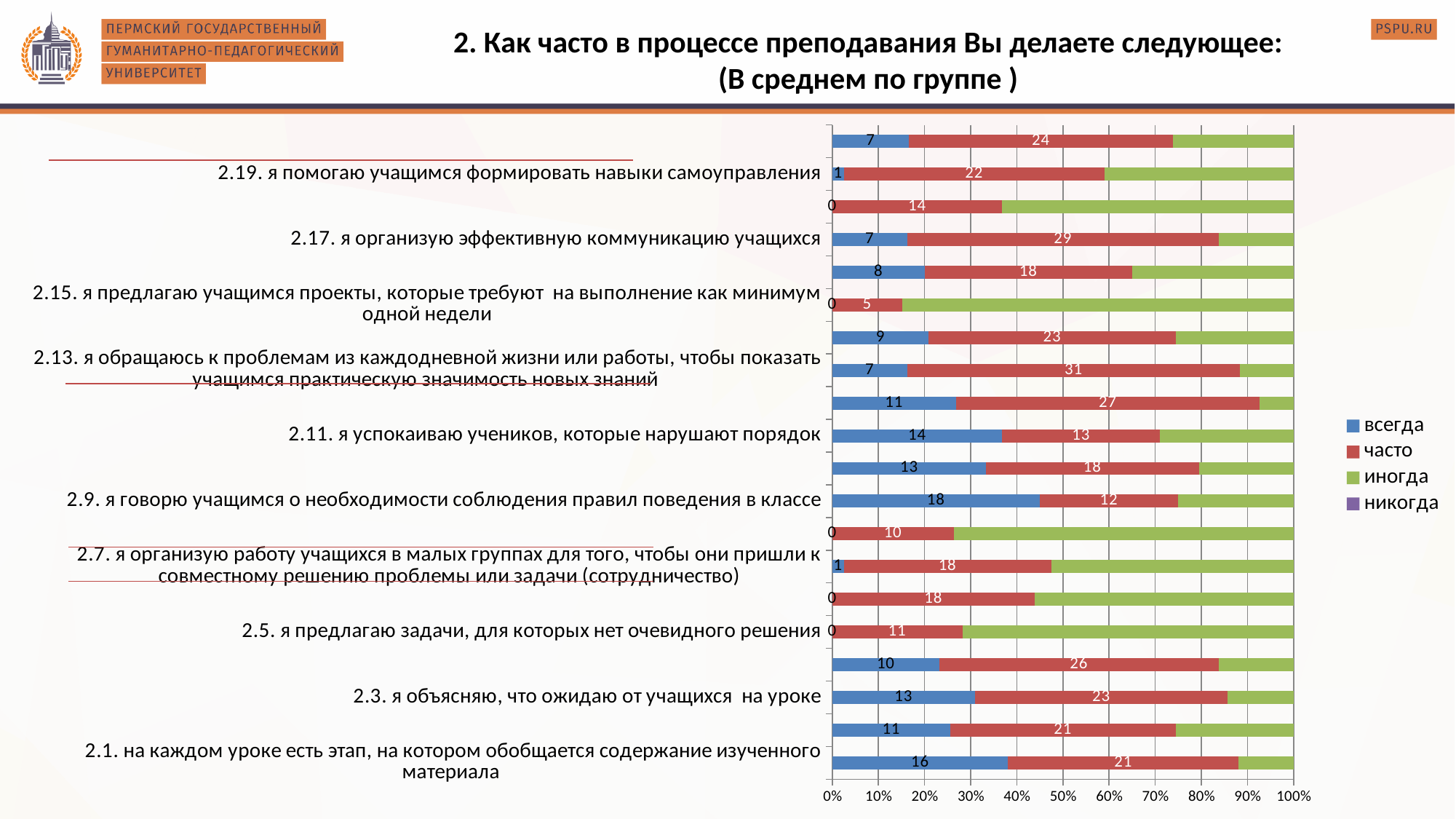
What is the value of the 'всегда' series for '2.5. я предлагаю задачи, для которых нет очевидного решения'? 0 Is the share of 'иногда' for '2.15. я предлагаю учащимся проекты, которые требуют на выполнение как минимум одной недели' greater or less than 80%? greater Which category has the highest value in the 'всегда' series? 2.9. я говорю учащимся о необходимости соблюдения правил поведения в классе Which has the larger 'часто' value: '2.17. я организую эффективную коммуникацию учащихся' or '2.11. я успокаиваю учеников, которые нарушают порядок'? 2.17. я организую эффективную коммуникацию учащихся What is the value of the 'часто' series for '2.15. я предлагаю учащимся проекты, которые требуют на выполнение как минимум одной недели'? 5 What is the difference between the 'всегда' values for '2.1. на каждом уроке есть этап...' and '2.3. я объясняю, что ожидаю от учащихся на уроке'? 3 How many series does the legend list? 4 What colour represents the 'часто' series in the legend? Red What is the value of the 'часто' series for '2.13. я обращаюсь к проблемам из каждодневной жизни или работы, чтобы показать учащимся практическую значимость новых знаний'? 31 What is the value of the 'всегда' series for '2.9. я говорю учащимся о необходимости соблюдения правил поведения в классе'? 18 What is the value of the 'всегда' series for '2.1. на каждом уроке есть этап, на котором обобщается содержание изученного материала'? 16 What kind of chart is shown on the slide? Stacked bar chart